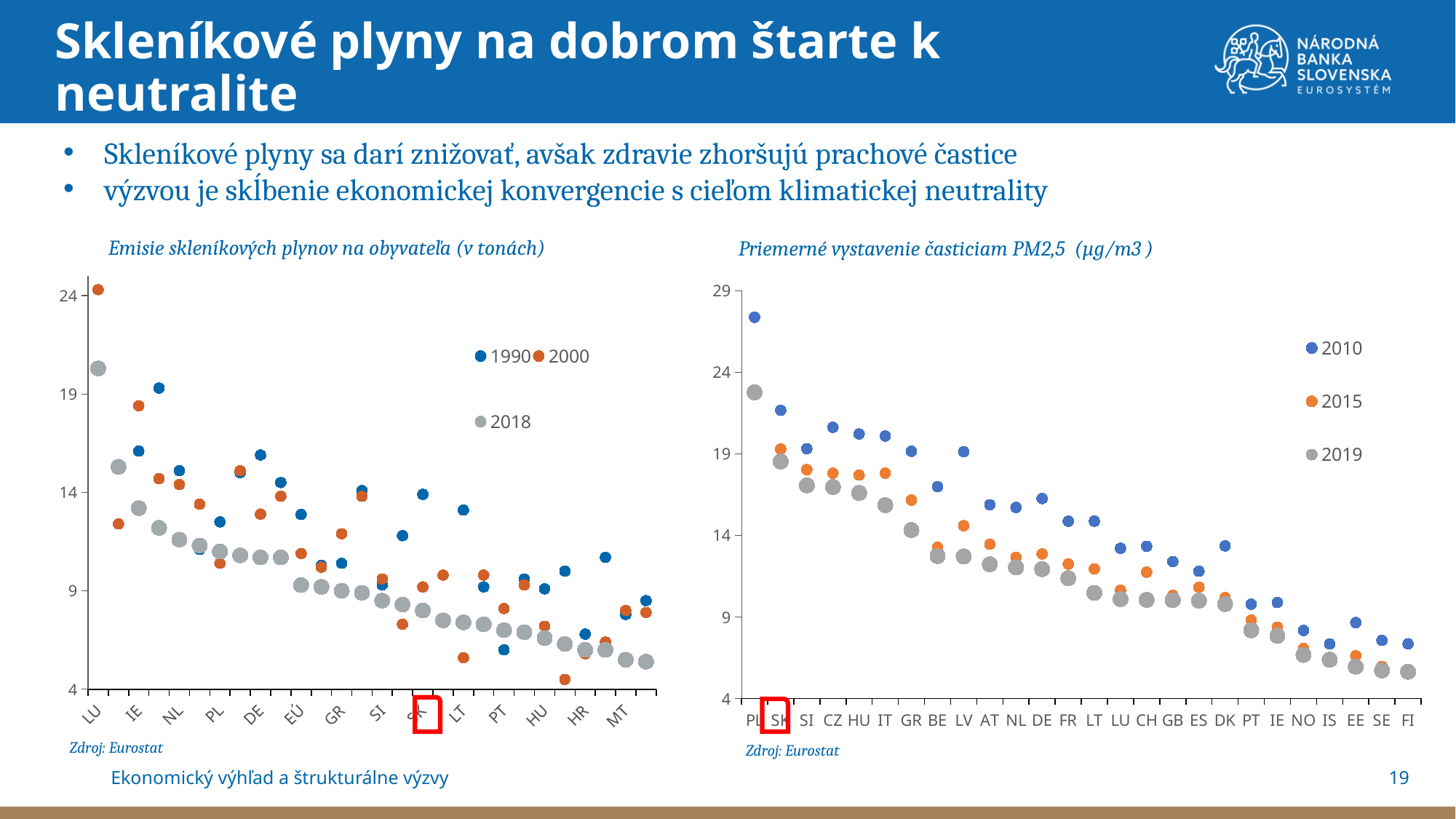
On the right chart (Priemerné vystavenie časticiam PM2,5), is the 2010 value for PL greater or less than 24? greater On the right chart (Priemerné vystavenie časticiam PM2,5), is the 2019 value for FI greater or less than 9? less On the right chart (Priemerné vystavenie časticiam PM2,5), how many countries are shown on the x axis? 26 On the right chart (Priemerné vystavenie časticiam PM2,5), which years does the legend list? 2010, 2015, 2019 On the right chart (Priemerné vystavenie časticiam PM2,5), is the 2010 value for SK greater or less than 19? greater On the right chart (Priemerné vystavenie časticiam PM2,5), which country has the highest 2010 value? PL On the left chart (Emisie skleníkových plynov na obyvateľa), how many series does the legend list? 3 What kind of chart is the right chart (Priemerné vystavenie časticiam PM2,5)? scatter (dot) chart On the left chart (Emisie skleníkových plynov na obyvateľa), which country has the highest 2018 value? LU On the right chart (Priemerné vystavenie časticiam PM2,5), do the 2010 values generally rise or fall from PL to FI along the x axis? fall On the left chart (Emisie skleníkových plynov na obyvateľa), which is larger: the 2018 value for LU or the 2018 value for IE? LU